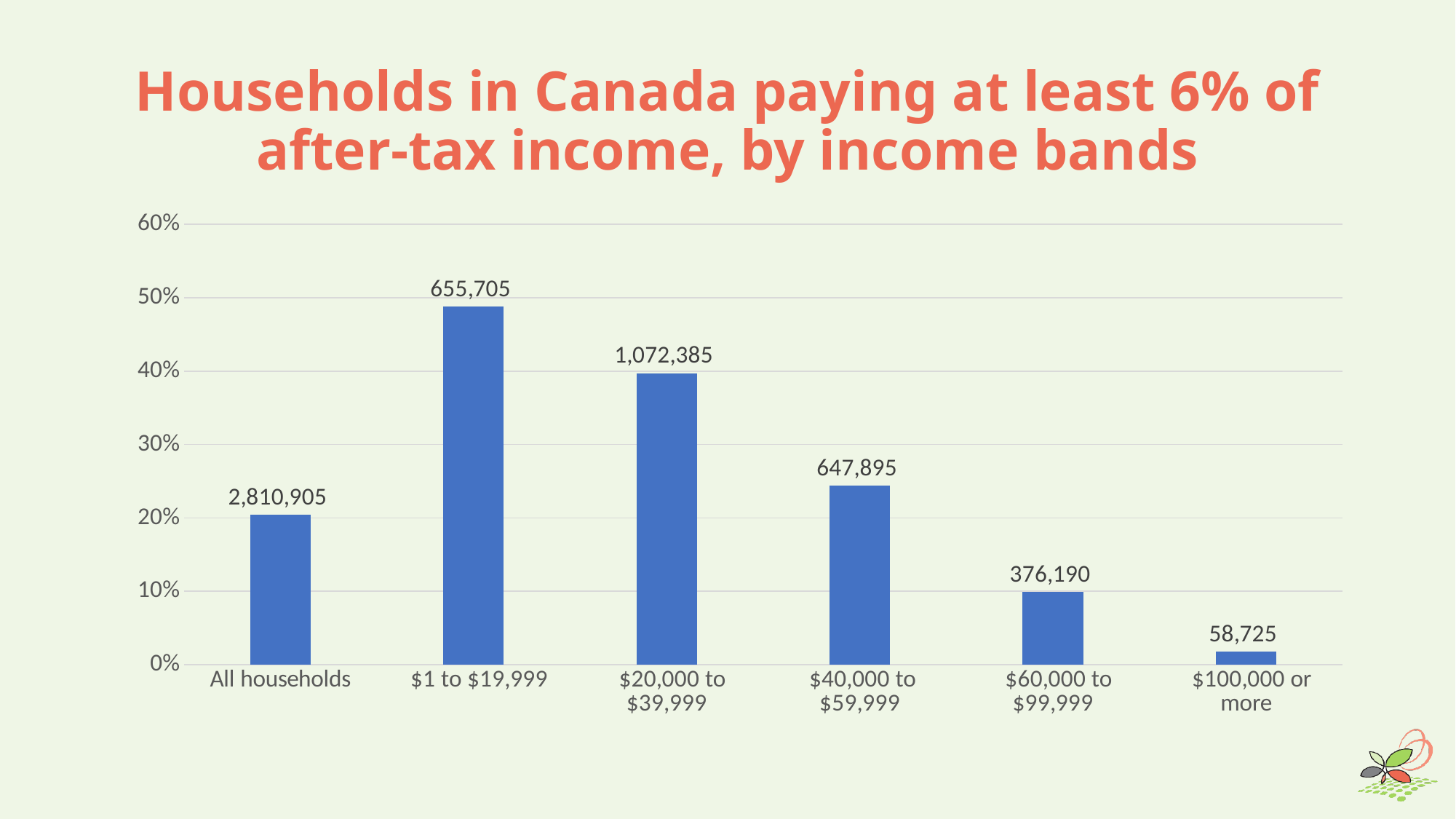
What is the data label shown above the bar for "All households"? 2,810,905 What is the data label shown above the bar for "$1 to $19,999"? 655,705 How many categories are shown on the x axis? 6 What is the difference between the data labels for "$20,000 to $39,999" and "$1 to $19,999"? 416,680 Which income band has the tallest bar? $1 to $19,999 What is the data label shown above the bar for "$100,000 or more"? 58,725 Which category has the shortest bar? $100,000 or more Is the bar for "$1 to $19,999" greater or less than 40%? greater Is the bar for "$100,000 or more" greater or less than 10%? less Which bar is taller: "$20,000 to $39,999" or "$40,000 to $59,999"? $20,000 to $39,999 What kind of chart is shown on the slide? bar chart What is the data label shown above the bar for "$60,000 to $99,999"? 376,190